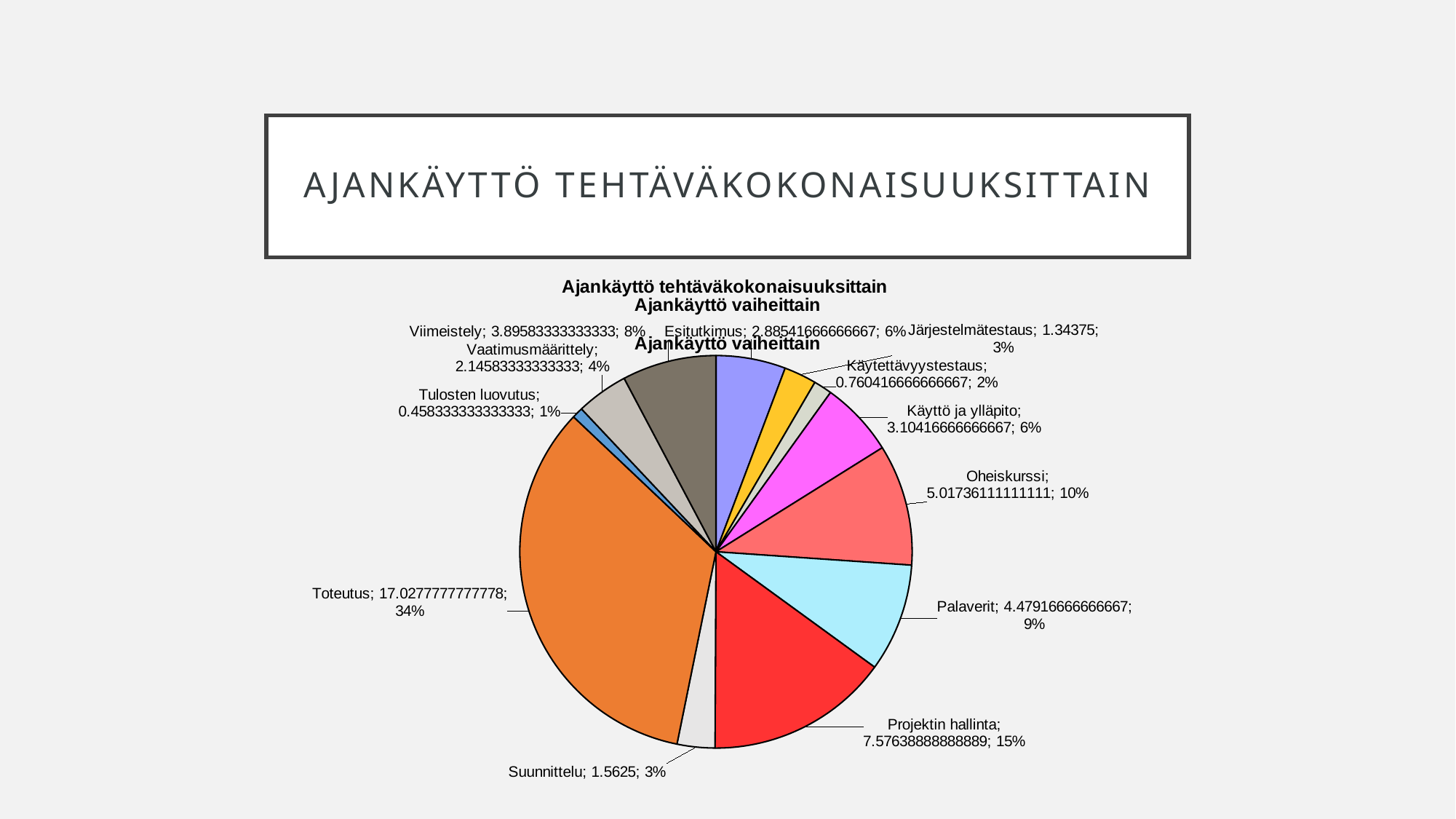
What value is shown for Suunnittelu? 1.5625 What percentage share does Projektin hallinta have? 15% Which is larger, the slice for Palaverit or the slice for Viimeistely? Palaverit What percentage share does Toteutus have? 34% Which category has the largest slice of the pie? Toteutus What percentage share does Oheiskurssi have? 10% What value is shown for Järjestelmätestaus? 1.34375 Which category has the smallest slice of the pie? Tulosten luovutus How many slices does the pie chart have? 12 What kind of chart is shown on the slide? pie chart What is the difference in percentage points between the shares of Toteutus and Projektin hallinta? 19